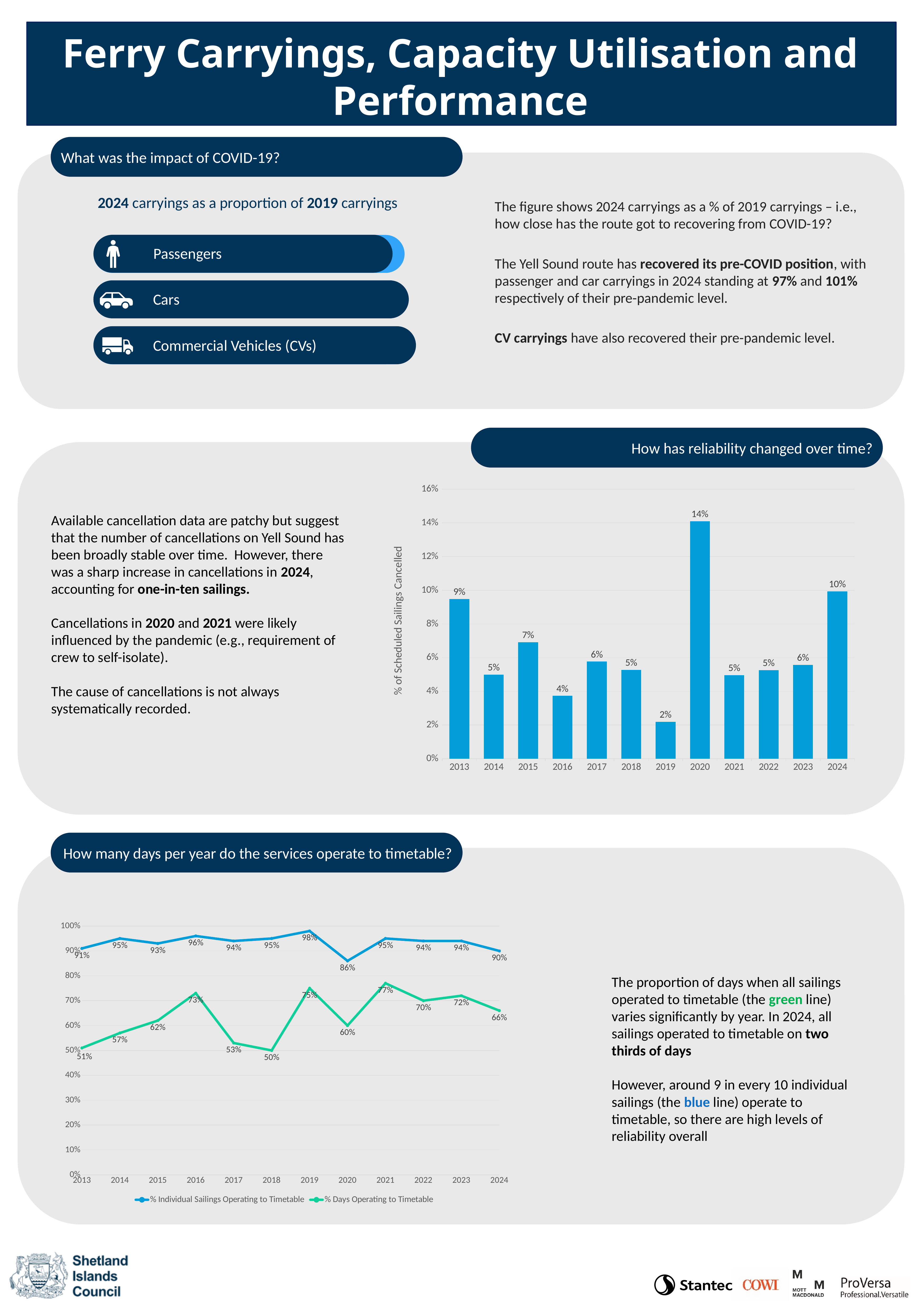
In the bar chart of % of scheduled sailings cancelled, which year had the lowest cancellation rate? 2019 In the bar chart of % of scheduled sailings cancelled, what is the difference between the 2024 value and the 2023 value? 4% In the bar chart of % of scheduled sailings cancelled, which year had the highest cancellation rate? 2020 In the line chart of services operating to timetable, which year had the highest % of individual sailings operating to timetable? 2019 In the bar chart of % of scheduled sailings cancelled, how many years are shown on the x axis? 12 In the line chart of services operating to timetable, what was the % of individual sailings operating to timetable in 2020? 86% What type of chart is used to show the % of scheduled sailings cancelled? Bar chart In the line chart of services operating to timetable, how many series does the legend list? 2 In the line chart of services operating to timetable, which year had the lowest % of days operating to timetable? 2018 In the line chart of services operating to timetable, what is the difference between the % of individual sailings and the % of days operating to timetable in 2013? 40% In the line chart of services operating to timetable, what was the % of days operating to timetable in 2024? 66% In the bar chart of % of scheduled sailings cancelled, what was the value for 2020? 14%